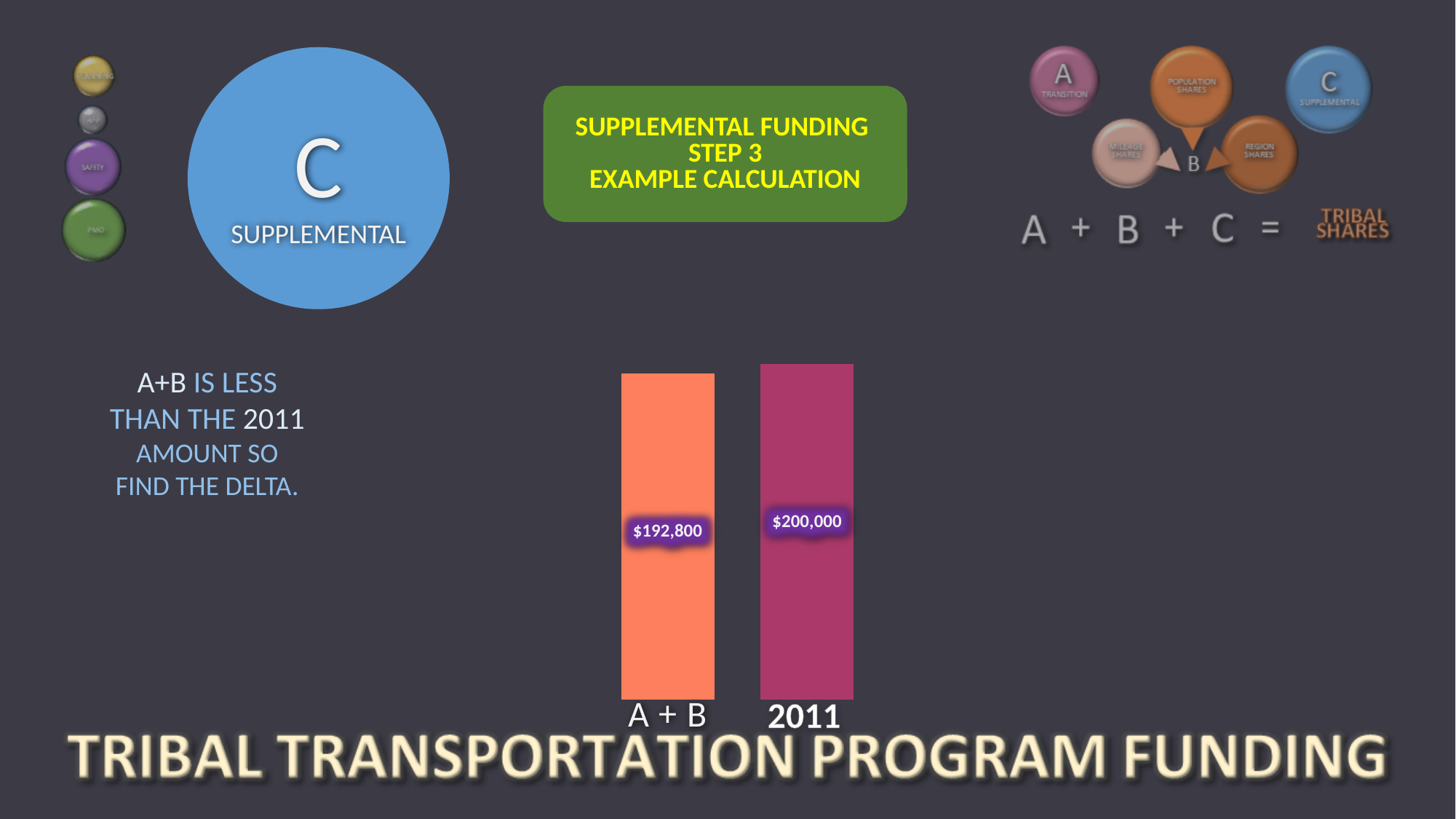
What kind of chart is shown on the slide? Bar chart What colour is the A + B bar? Orange Which category has the highest value? 2011 What is the value shown for the A + B bar? $192,800 How many bars are shown in the chart? 2 Which category has the lowest value? A + B What is the value shown for the 2011 bar? $200,000 What colour is the 2011 bar? Magenta Which bar is taller, A + B or 2011? 2011 Do the values rise or fall from the A + B bar to the 2011 bar? Rise What is the difference between the 2011 value and the A + B value? $7,200